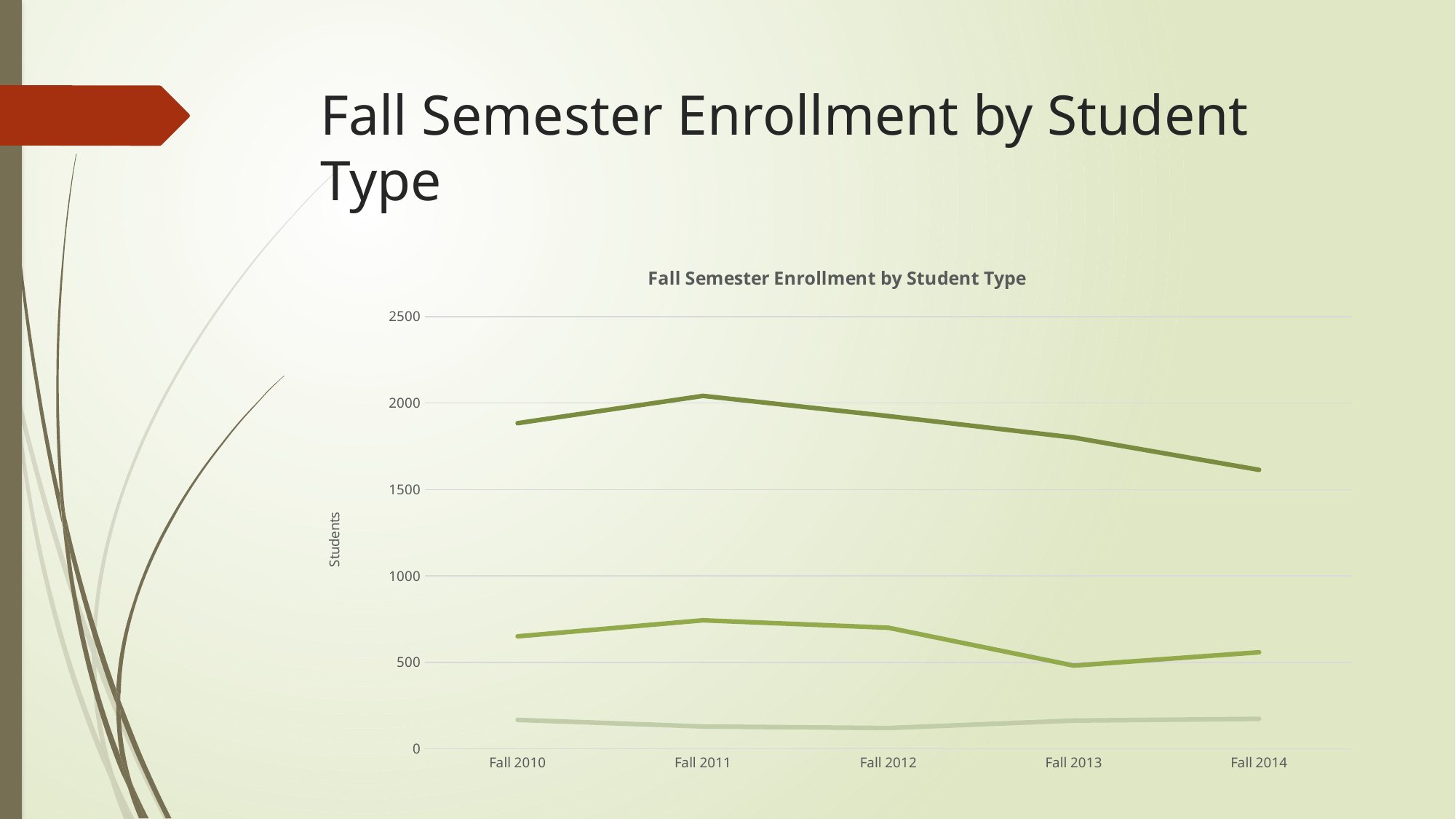
What is the title of the chart? Fall Semester Enrollment by Student Type At Fall 2014, which is larger: the value of the top line or the value of the middle line? the top line Is the value of the middle line for Fall 2011 greater or less than 500? greater In which semester does the top line reach its highest value? Fall 2011 Is the value of the top line for Fall 2014 greater or less than 1500? greater Is the value of the top line for Fall 2010 greater or less than 2000? less What is the label on the vertical axis? Students Does the top line rise or fall from Fall 2011 to Fall 2014? fall What kind of chart is shown on the slide? line chart How many semesters are plotted along the x axis? 5 In which semester does the middle line reach its lowest value? Fall 2013